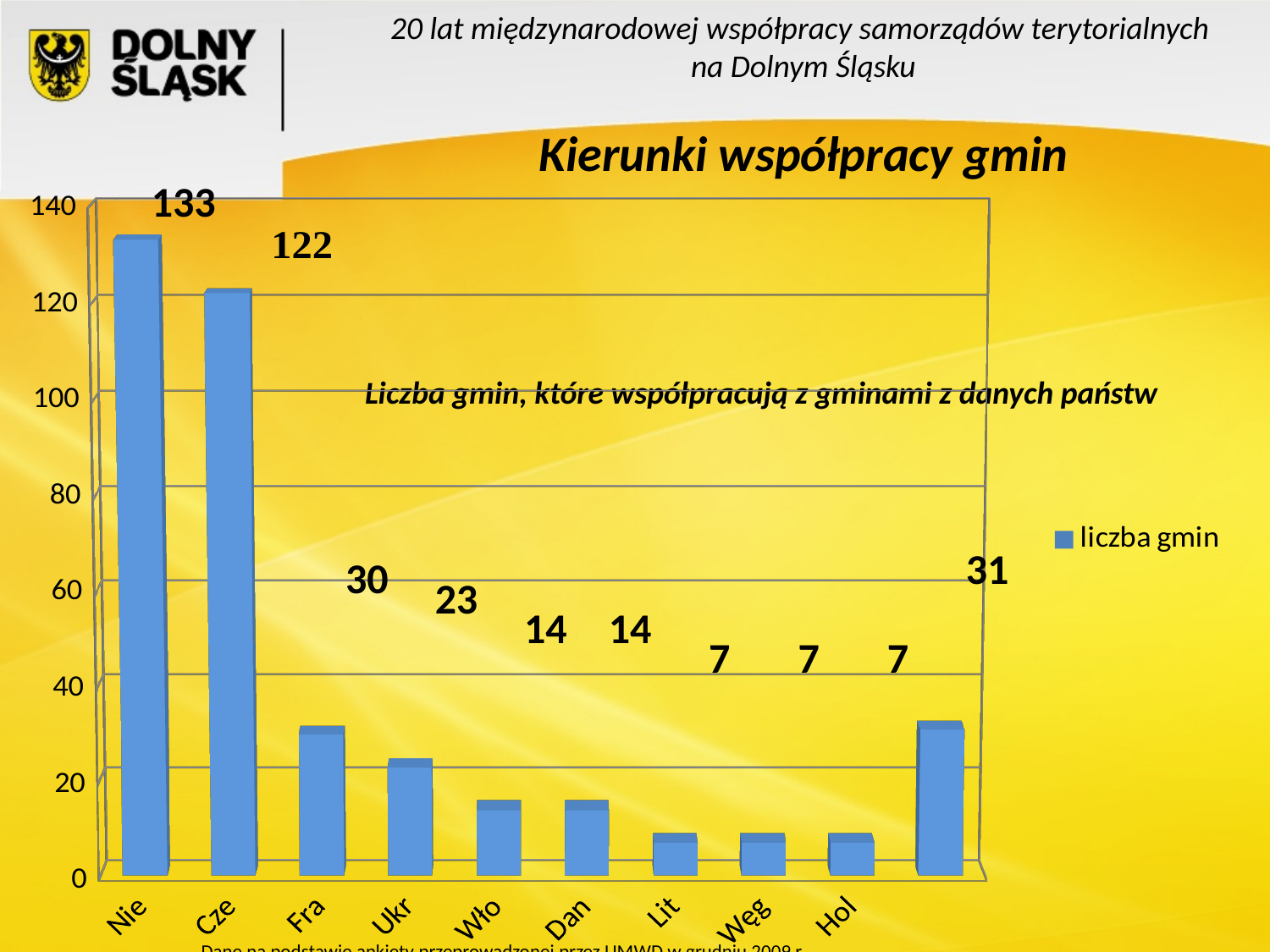
Which category has the highest value? Nie What is the value for Fra? 30 How many bars are plotted in the chart? 10 What is the value for Ukr? 23 Is the value for Cze greater or less than 100? greater How many series does the legend list? 1 What is the value for Nie? 133 What is the legend entry of the chart? liczba gmin Which is larger, the value for Fra or the value for Ukr? Fra What kind of chart is shown on the slide? bar chart What is the difference between the values for Nie and Cze? 11 What is the value for Cze? 122